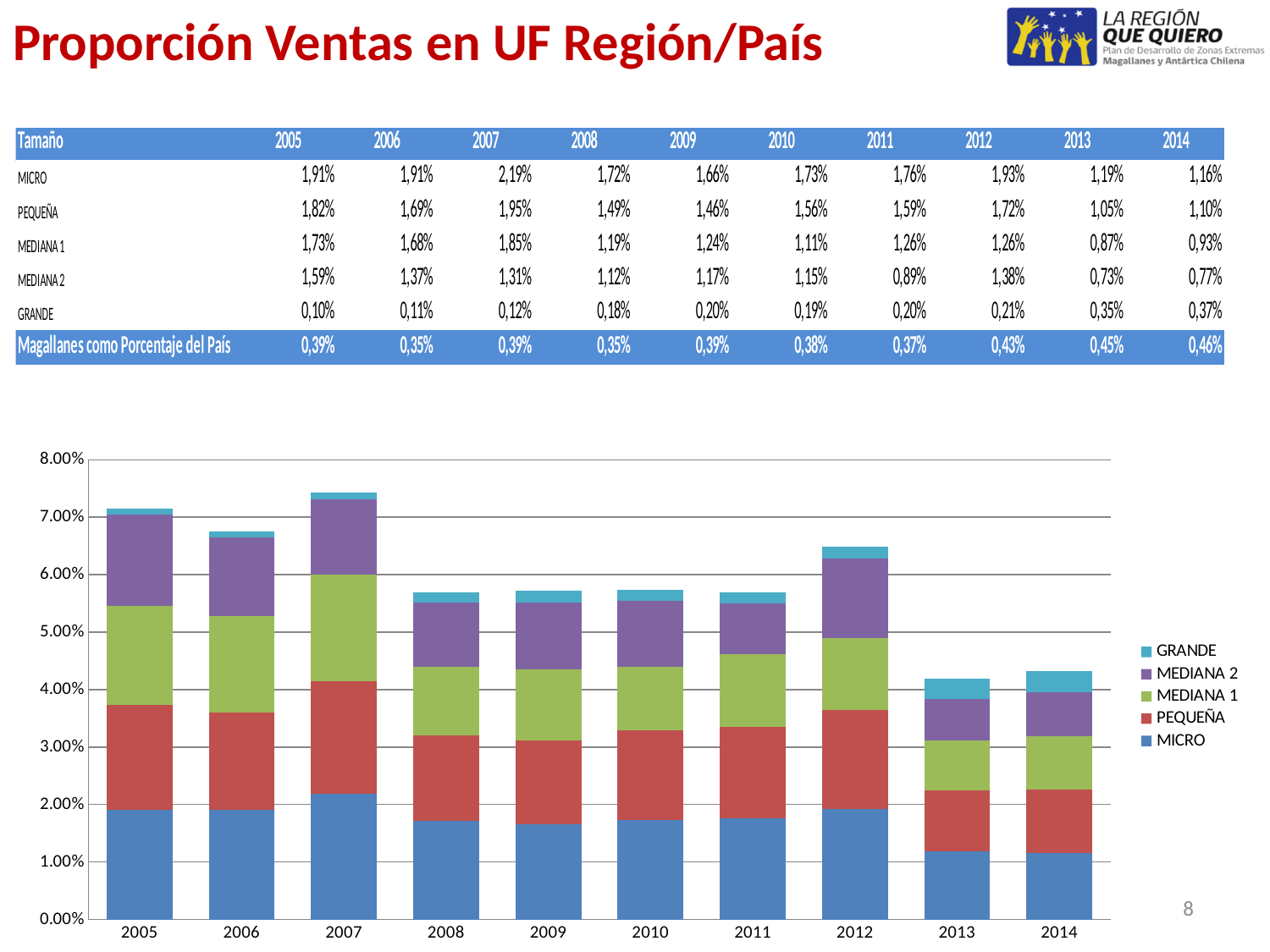
Is the total stacked bar for 2013 greater or less than 5.00%? less Which is larger, the MICRO value for 2005 or for 2013? 2005 How many series does the chart's legend list? 5 What is the GRANDE value for 2014? 0,37% Which year has the tallest stacked bar in the chart? 2007 How many years are shown along the x axis of the chart? 10 What kind of chart is shown on the slide? Stacked bar chart What is the MICRO value for 2007? 2,19% Is the total stacked bar for 2012 greater or less than 6.00%? greater What is the difference between the MICRO value for 2007 and for 2014? 1,03% What is the total of the stacked bar for 2005? 7,15% Does the GRANDE series generally rise or fall from 2005 to 2014? rise